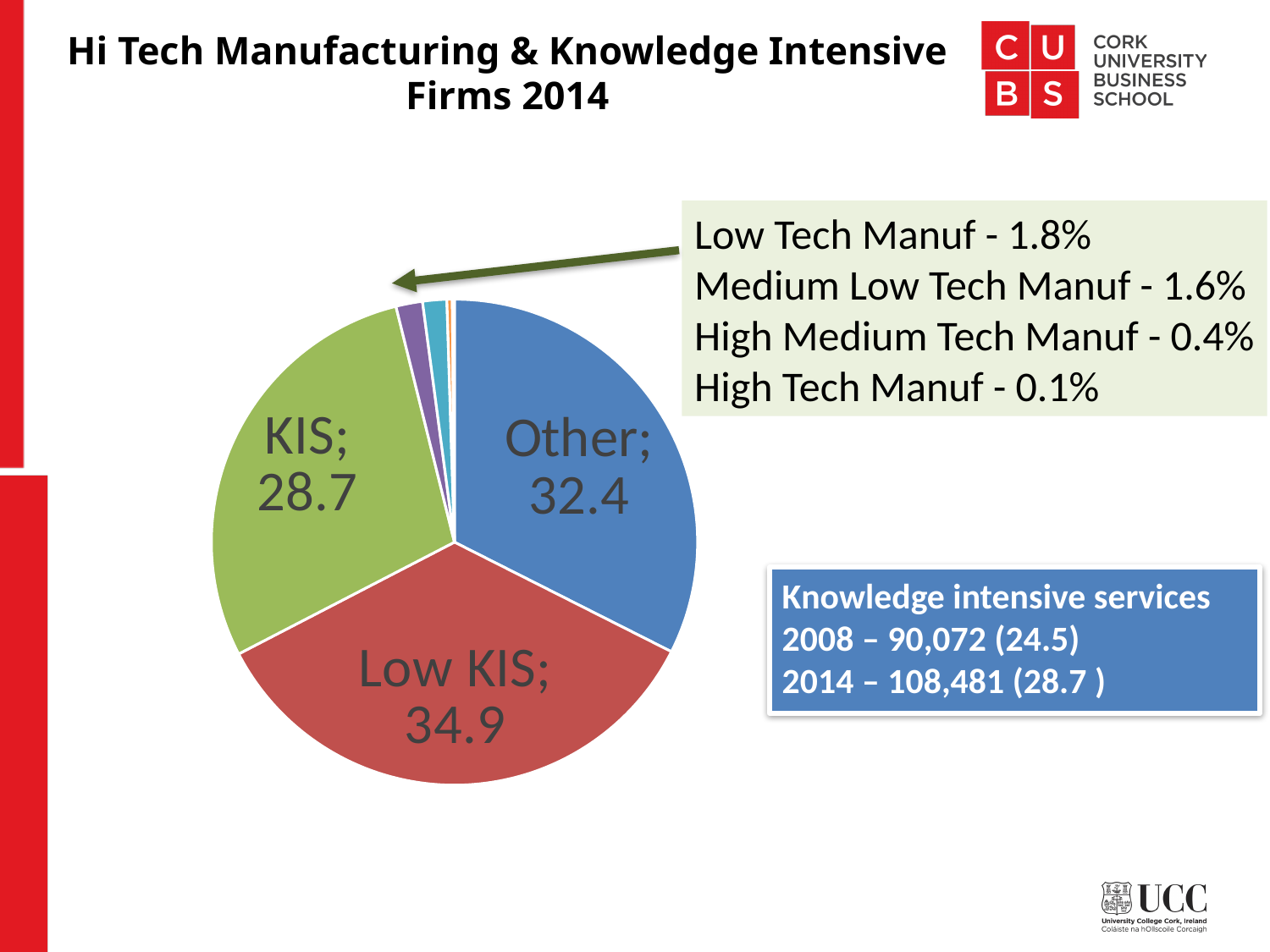
Which category has the smallest share of the pie? High Tech Manuf What is the value shown for the KIS slice? 28.7 What is the value shown for the Other slice? 32.4 What kind of chart is shown on the slide? Pie chart How many categories are shown in the pie chart, including the small slices listed in the text box? 7 What is the title of the slide containing the pie chart? Hi Tech Manufacturing & Knowledge Intensive Firms 2014 Which is larger, the Other slice or the KIS slice? Other Which category has the largest slice of the pie? Low KIS What is the difference between the Low KIS value and the Other value? 2.5 What percentage is given for Low Tech Manuf? 1.8% What percentage is given for High Tech Manuf? 0.1% What is the value shown for the Low KIS slice? 34.9